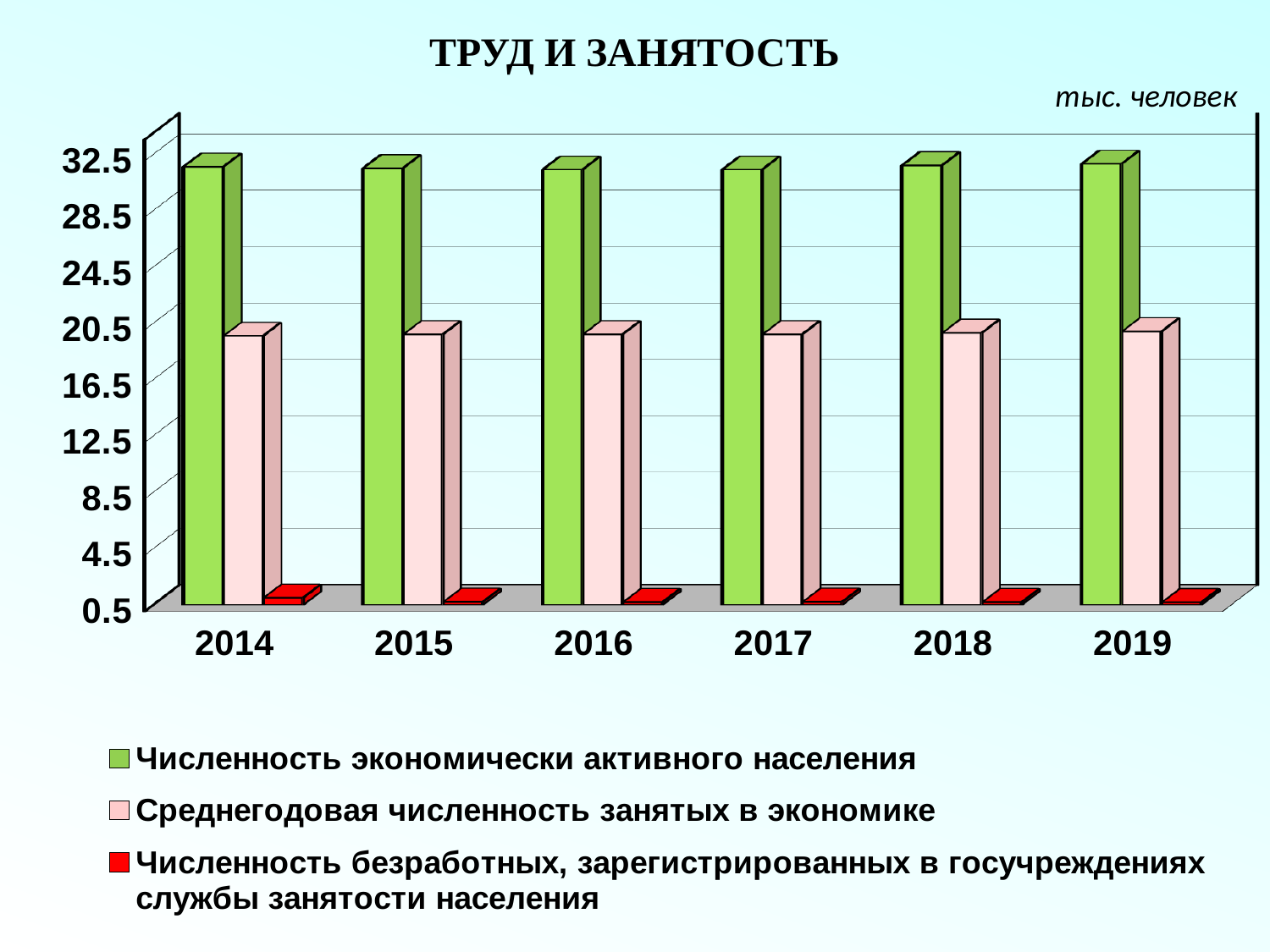
In what units are the values on the chart given? тыс. человек How many years are shown on the x axis of the chart? 6 Is the value for Среднегодовая численность занятых в экономике in 2016 greater or less than 16.5? greater Is the value for Численность безработных, зарегистрированных в госучреждениях службы занятости населения in 2017 greater or less than 4.5? less In 2015, which is larger: Численность экономически активного населения or Среднегодовая численность занятых в экономике? Численность экономически активного населения In 2018, which is larger: Среднегодовая численность занятых в экономике or Численность безработных, зарегистрированных в госучреждениях службы занятости населения? Среднегодовая численность занятых в экономике What kind of chart is shown on the slide? bar chart Is the value for Среднегодовая численность занятых в экономике in 2019 greater or less than 24.5? less Which series has the lowest values in every year shown? Численность безработных, зарегистрированных в госучреждениях службы занятости населения How many series does the legend list? 3 What is the title of the chart? ТРУД И ЗАНЯТОСТЬ